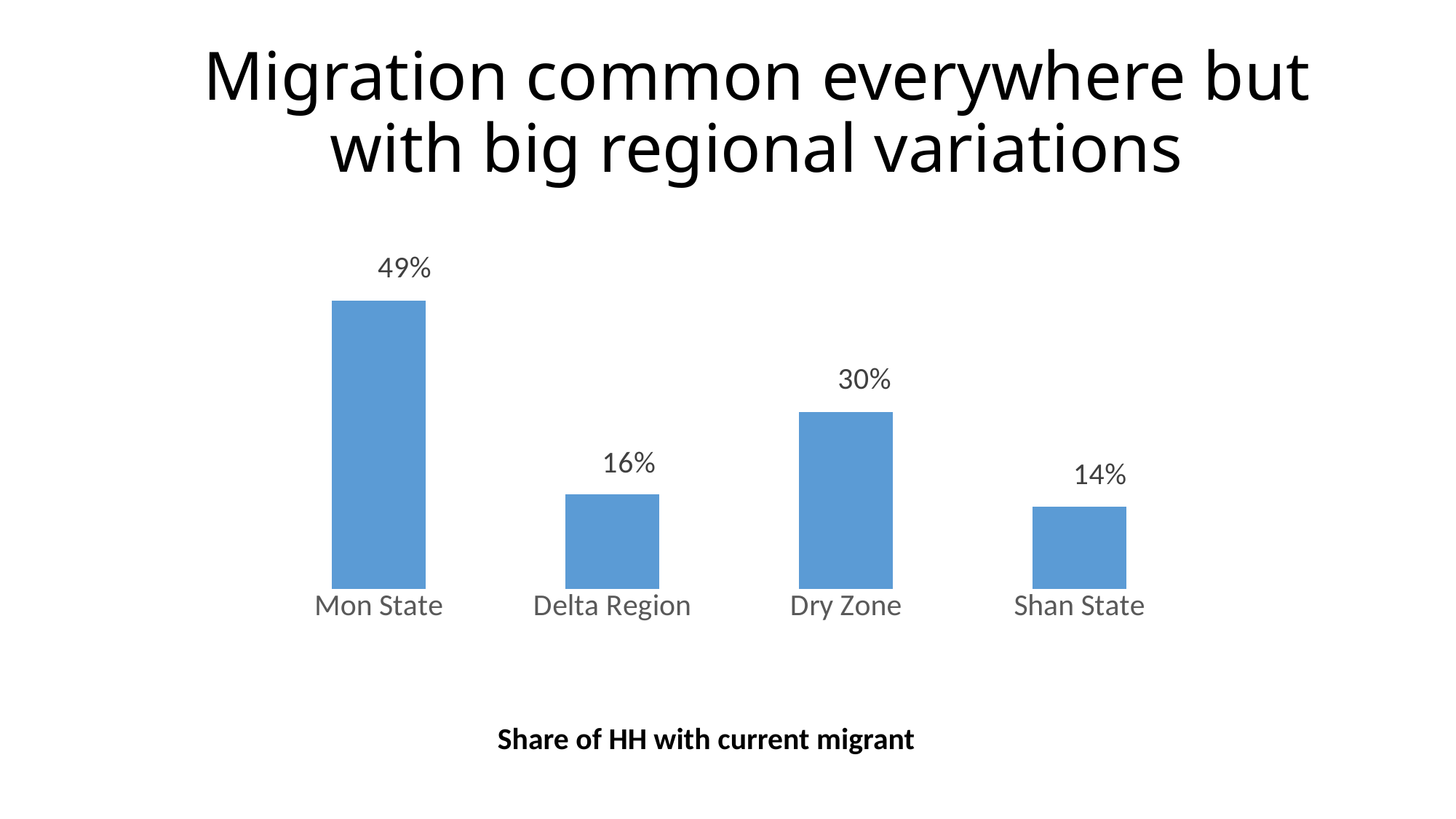
What is the difference between the share for Delta Region and the share for Shan State? 2% What is the share of HH with current migrant for Dry Zone? 30% What is the share of HH with current migrant for Delta Region? 16% What is the share of HH with current migrant for Mon State? 49% What kind of chart is shown on the slide? Bar chart What is the title of the chart? Share of HH with current migrant Which region has the highest share of HH with current migrant? Mon State What is the difference between the share for Mon State and the share for Dry Zone? 19% Which region has the lowest share of HH with current migrant? Shan State How many regions are shown in the chart? 4 What is the share of HH with current migrant for Shan State? 14% Which has a larger share of HH with current migrant, Dry Zone or Delta Region? Dry Zone